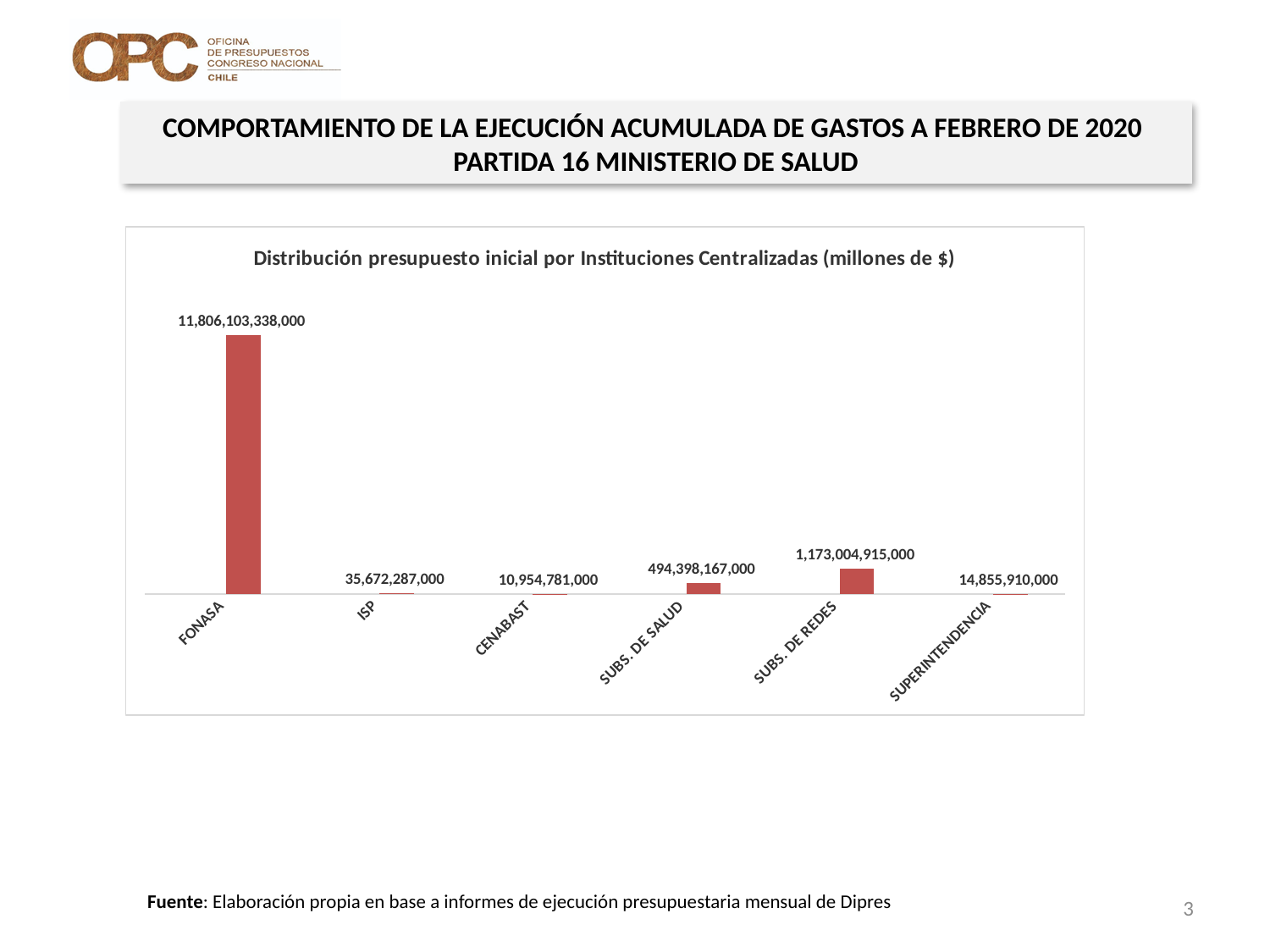
Which institution has the highest value? FONASA What is the value for FONASA? 11,806,103,338,000 What is the value for CENABAST? 10,954,781,000 What kind of chart is shown on the slide? Bar chart What is the value for SUBS. DE REDES? 1,173,004,915,000 How many institutions are shown in the chart? 6 Which is larger, the value for ISP or the value for SUPERINTENDENCIA? ISP What is the value for SUPERINTENDENCIA? 14,855,910,000 What is the value for ISP? 35,672,287,000 What is the difference between the values for SUBS. DE REDES and SUBS. DE SALUD? 678,606,748,000 What is the value for SUBS. DE SALUD? 494,398,167,000 Which institution has the lowest value? CENABAST